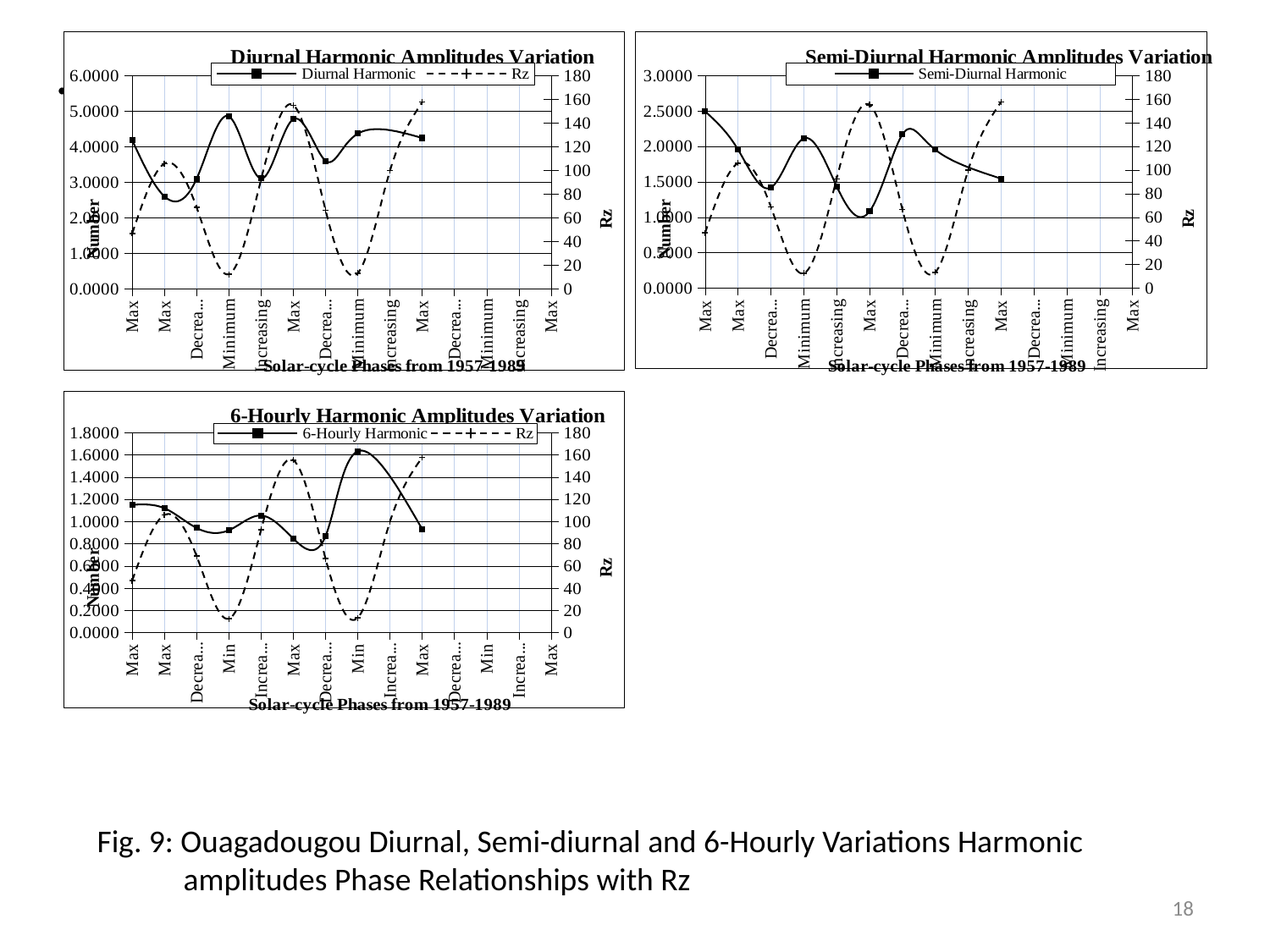
How many solar-cycle phase categories are shown along the x axis of the Diurnal Harmonic Amplitudes Variation chart? 14 In the Semi-Diurnal Harmonic Amplitudes Variation chart, is the Semi-Diurnal Harmonic value at the first category greater or less than 2.0000? greater In the Diurnal Harmonic Amplitudes Variation chart, is the Diurnal Harmonic value at the second category (Max) greater or less than 3.0000? less In the 6-Hourly Harmonic Amplitudes Variation chart, is the Rz value at the first Min category greater or less than 40? less What is the x-axis title of the Diurnal Harmonic Amplitudes Variation chart? Solar-cycle Phases from 1957-1989 In the 6-Hourly Harmonic Amplitudes Variation chart, what are the two series named in the legend? 6-Hourly Harmonic and Rz What kind of chart is the Diurnal Harmonic Amplitudes Variation chart? line chart How many series does the legend of the Semi-Diurnal Harmonic Amplitudes Variation chart list? 2 In the Diurnal Harmonic Amplitudes Variation chart, which is larger: the Diurnal Harmonic value at the first Minimum category or at the second category (Max)? the first Minimum category